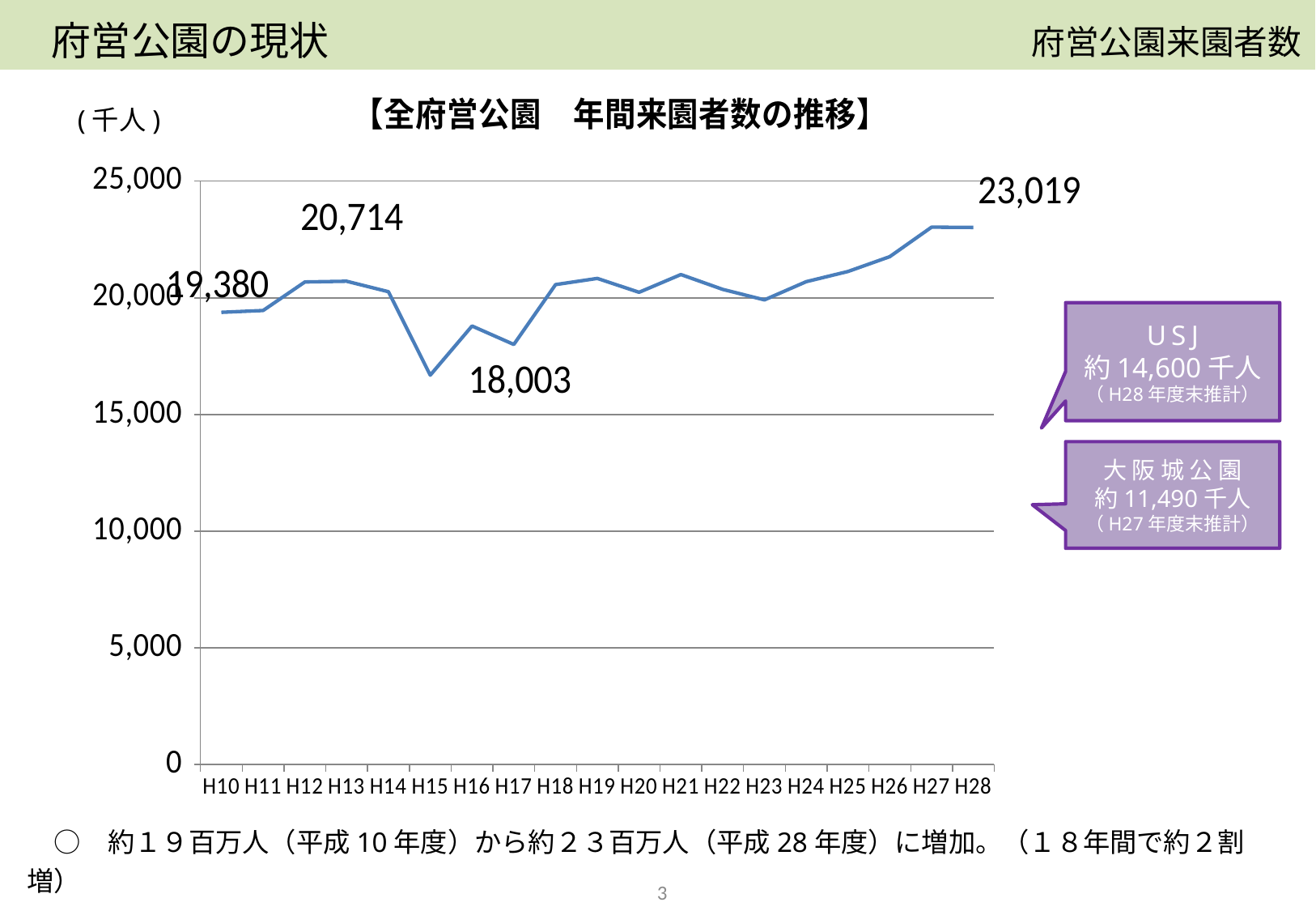
What kind of chart is shown on the slide? line chart Overall, do the values rise or fall from H10 to H28? rise What is the value for H28? 23,019 What is the difference between the values for H28 and H10? 3,639 What unit is shown for the y axis of the chart? 千人 Which is larger, the value for H15 or the value for H17? H17 Is the value for H27 greater or less than 20,000? greater How many years are plotted on the x axis? 19 What is the value for H10? 19,380 Which year has the lowest value on the chart? H15 Which is larger, the value for H10 or the value for H28? H28 Is the value for H15 greater or less than 20,000? less